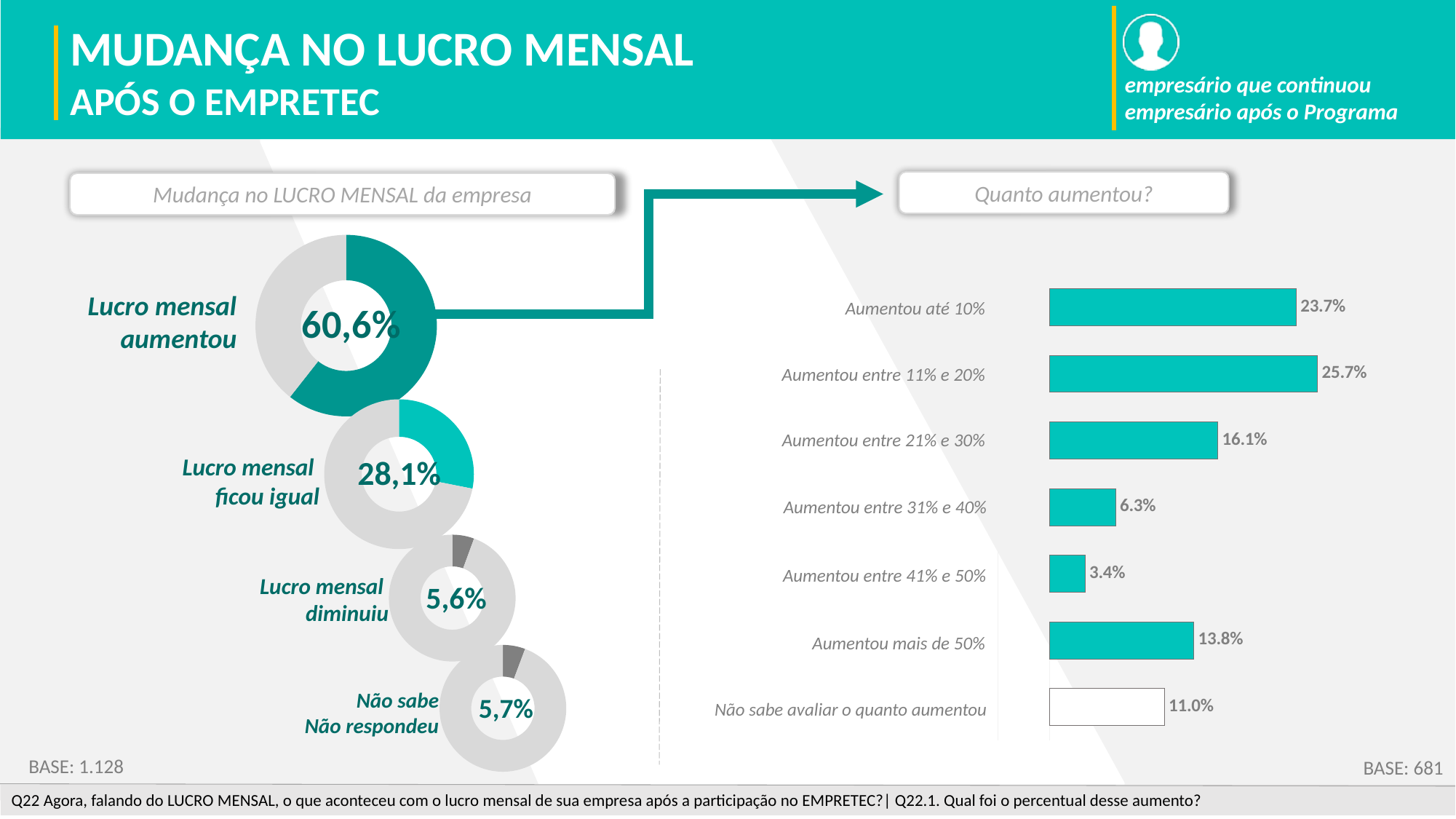
In the 'Quanto aumentou?' bar chart, which category has the highest value? Aumentou entre 11% e 20% What is the base (number of respondents) shown for the 'Quanto aumentou?' bar chart? 681 In the donut charts on the left, what percentage is shown for 'Lucro mensal diminuiu'? 5,6% In the 'Quanto aumentou?' bar chart, which category has the lowest value? Aumentou entre 41% e 50% How many categories are shown in the 'Quanto aumentou?' bar chart? 7 What kind of chart is the 'Quanto aumentou?' chart on the right of the slide? Bar chart In the donut charts on the left, what is the difference between 'Lucro mensal aumentou' and 'Lucro mensal ficou igual'? 32,5% In the 'Quanto aumentou?' bar chart, what is the value for 'Aumentou entre 11% e 20%'? 25.7% In the 'Quanto aumentou?' bar chart, what is the value for 'Aumentou mais de 50%'? 13.8% In the 'Quanto aumentou?' bar chart, what is the difference between 'Aumentou entre 21% e 30%' and 'Aumentou entre 31% e 40%'? 9.8% In the donut charts on the left, what percentage is shown for 'Lucro mensal aumentou'? 60,6% In the 'Quanto aumentou?' bar chart, which is larger: 'Aumentou mais de 50%' or 'Não sabe avaliar o quanto aumentou'? Aumentou mais de 50%